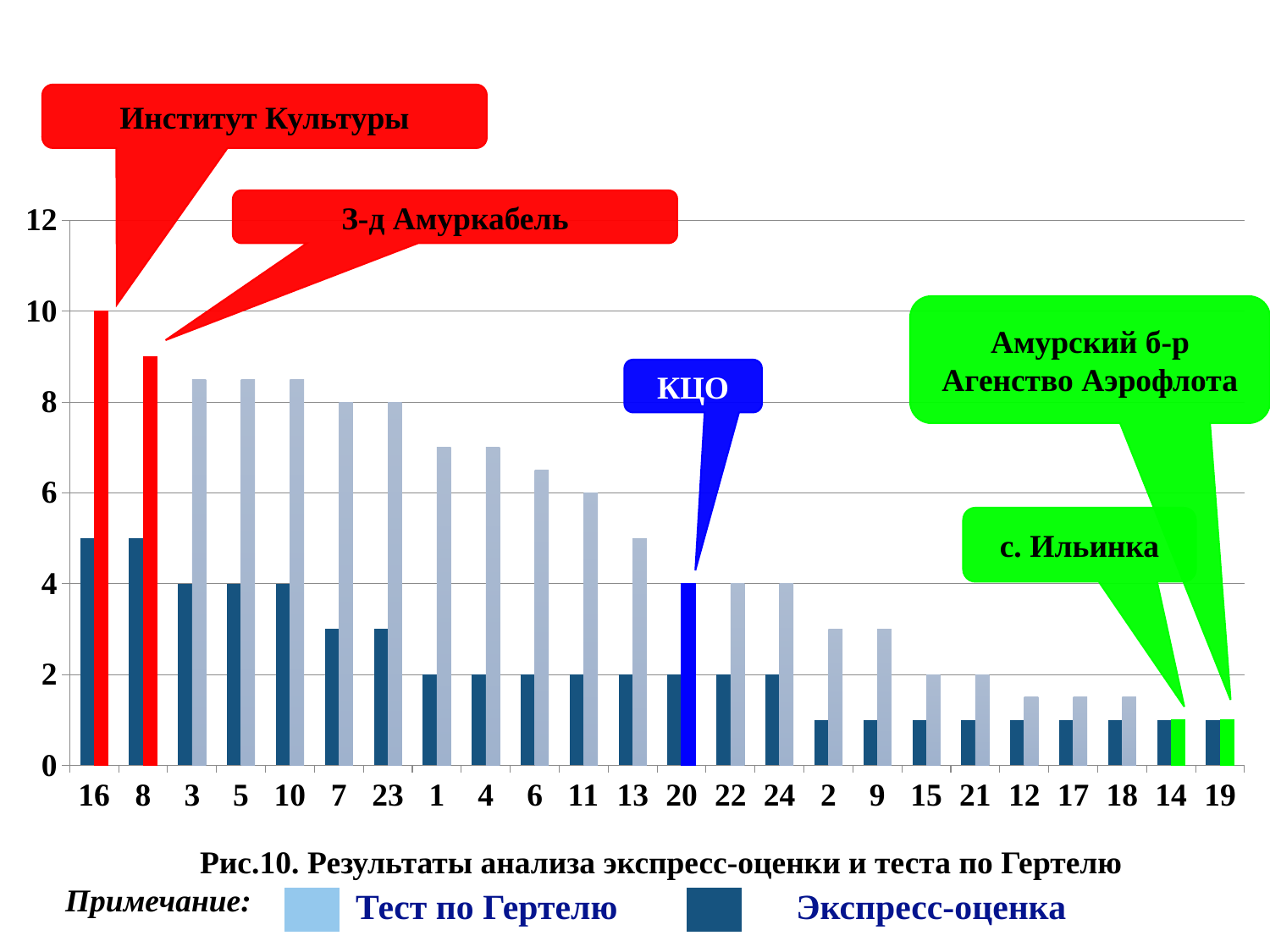
What is the value of Экспресс-оценка for category 20? 2 What is the value of Тест по Гертелю for category 16? 10 Do the Тест по Гертелю values generally rise or fall from left to right along the x axis? fall What kind of chart is shown on the slide? bar chart What is the value of Тест по Гертелю for category 20? 4 How many categories are shown along the x axis? 24 What is the value of Тест по Гертелю for category 7? 8 Is the value of Тест по Гертелю for category 8 greater or less than 8? greater Is the value of Тест по Гертелю for category 13 greater or less than 6? less Which category has the highest value for Тест по Гертелю? 16 How many series does the legend list? 2 For category 20, what is the difference between Тест по Гертелю and Экспресс-оценка? 2